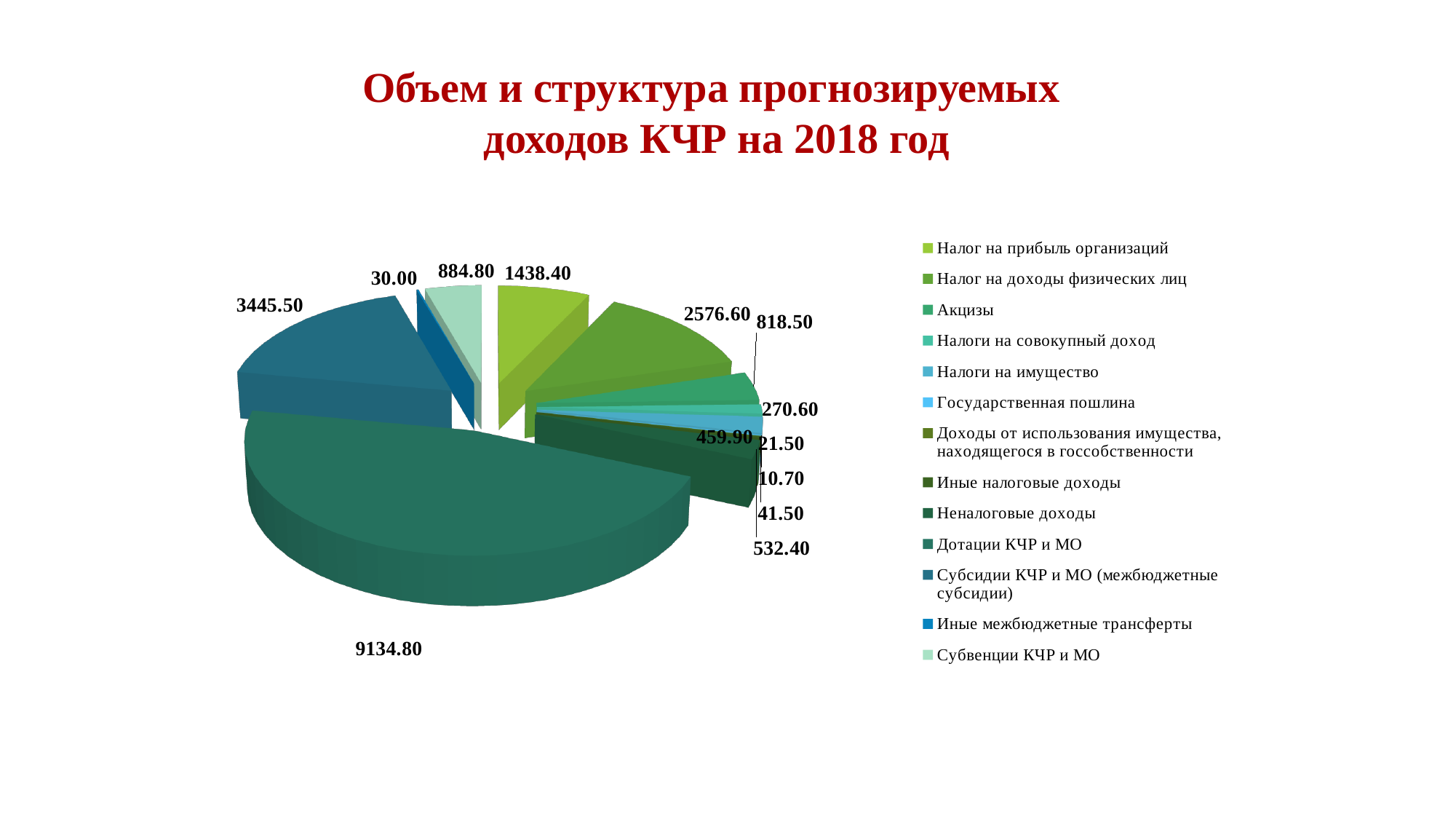
What is the title of the slide? Объем и структура прогнозируемых доходов КЧР на 2018 год What is the value labelled for Налог на доходы физических лиц? 2576.60 What is the value labelled for Субсидии КЧР и МО (межбюджетные субсидии)? 3445.50 What is the value labelled for Налог на прибыль организаций? 1438.40 What is the difference between the values for Налог на доходы физических лиц and Налог на прибыль организаций? 1138.20 What is the smallest value labelled on the pie chart? 10.70 How many categories does the legend of the pie chart list? 13 What is the value labelled for Субвенции КЧР и МО? 884.80 What kind of chart is shown on the slide? Pie chart Which is larger: the value for Субсидии КЧР и МО (межбюджетные субсидии) or the value for Субвенции КЧР и МО? Субсидии КЧР и МО (межбюджетные субсидии) What is the value labelled for Дотации КЧР и МО? 9134.80 Which category has the largest slice in the pie chart? Дотации КЧР и МО